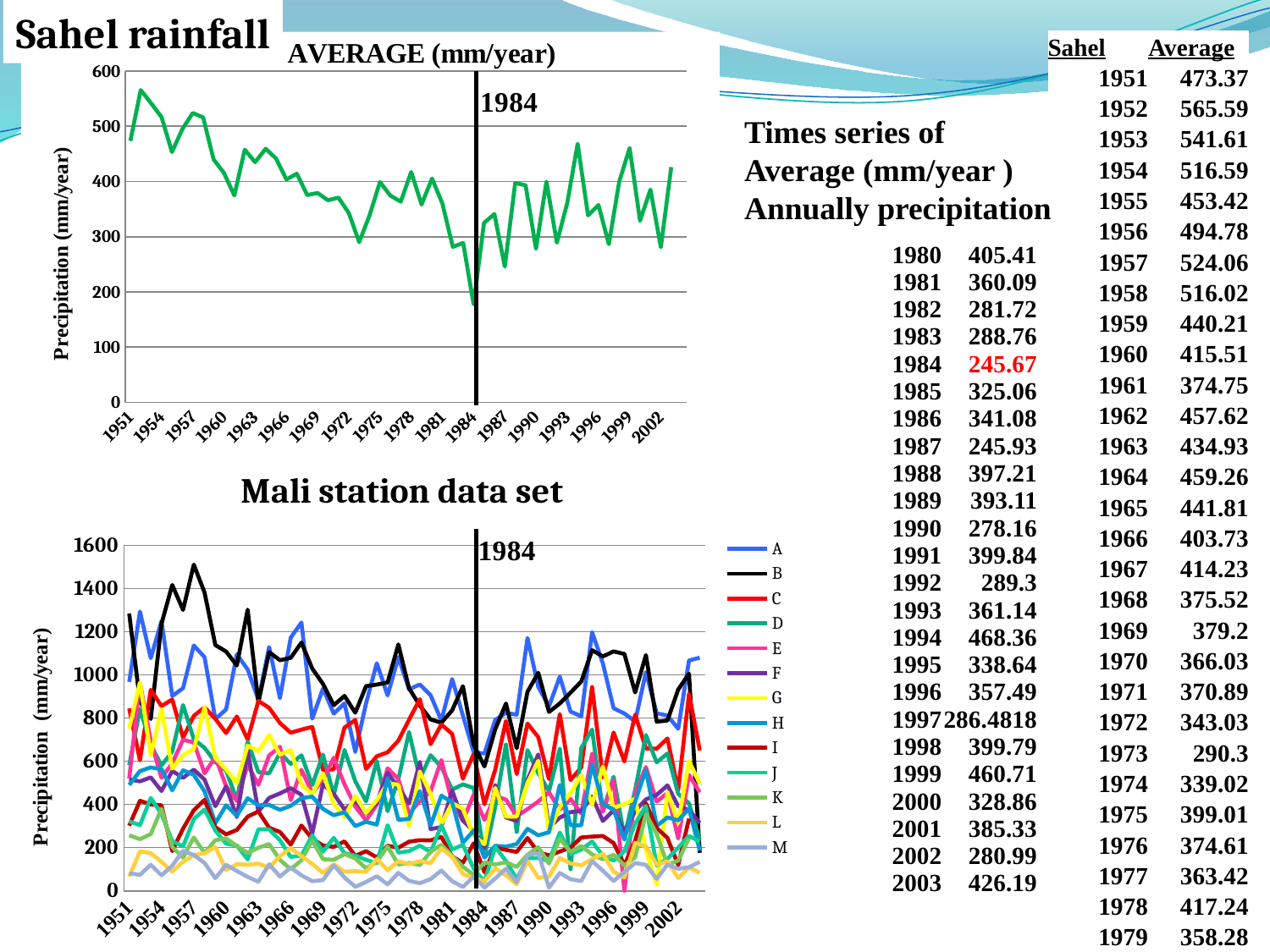
In the 'AVERAGE (mm/year)' chart, which year has the highest precipitation? 1952 In the 'AVERAGE (mm/year)' chart, is the value for 1984 greater or less than 300? less How many series does the legend of the 'Mali station data set' chart list? 13 What kind of chart is the top chart titled 'AVERAGE (mm/year)'? line chart In the 'AVERAGE (mm/year)' chart, what is the precipitation value for 1952? 565.59 In the 'AVERAGE (mm/year)' chart, do the values generally rise or fall from 1951 to 1984? fall How many years are plotted in the 'AVERAGE (mm/year)' chart? 53 In the 'AVERAGE (mm/year)' chart, which year has the larger value, 1951 or 2003? 1951 Which year is marked by the vertical black line in both charts? 1984 In the 'AVERAGE (mm/year)' chart, what is the precipitation value for 1994? 468.36